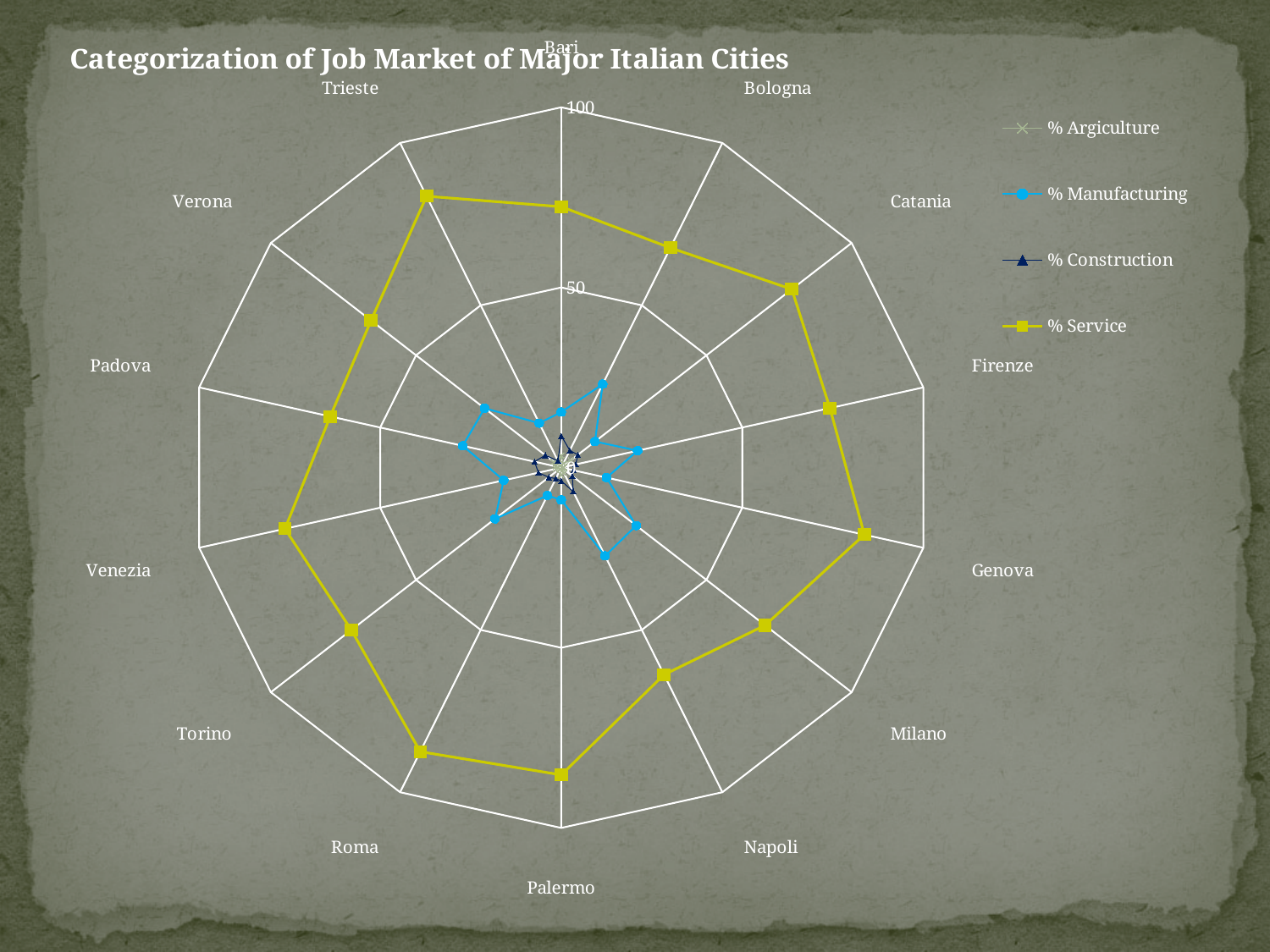
Is the % Manufacturing value for Bari greater or less than 50? less Is the % Service value for Genova greater or less than 50? greater Which city has the larger % Service value, Genova or Padova? Genova How many series does the legend list? 4 Is the % Service value for Padova greater or less than 50? greater What is the title of the chart? Categorization of Job Market of Major Italian Cities Which series is drawn with yellow square markers? % Service For Bari, which is larger: % Service or % Manufacturing? % Service How many cities are plotted on the chart? 14 What kind of chart is shown on the slide? Radar chart